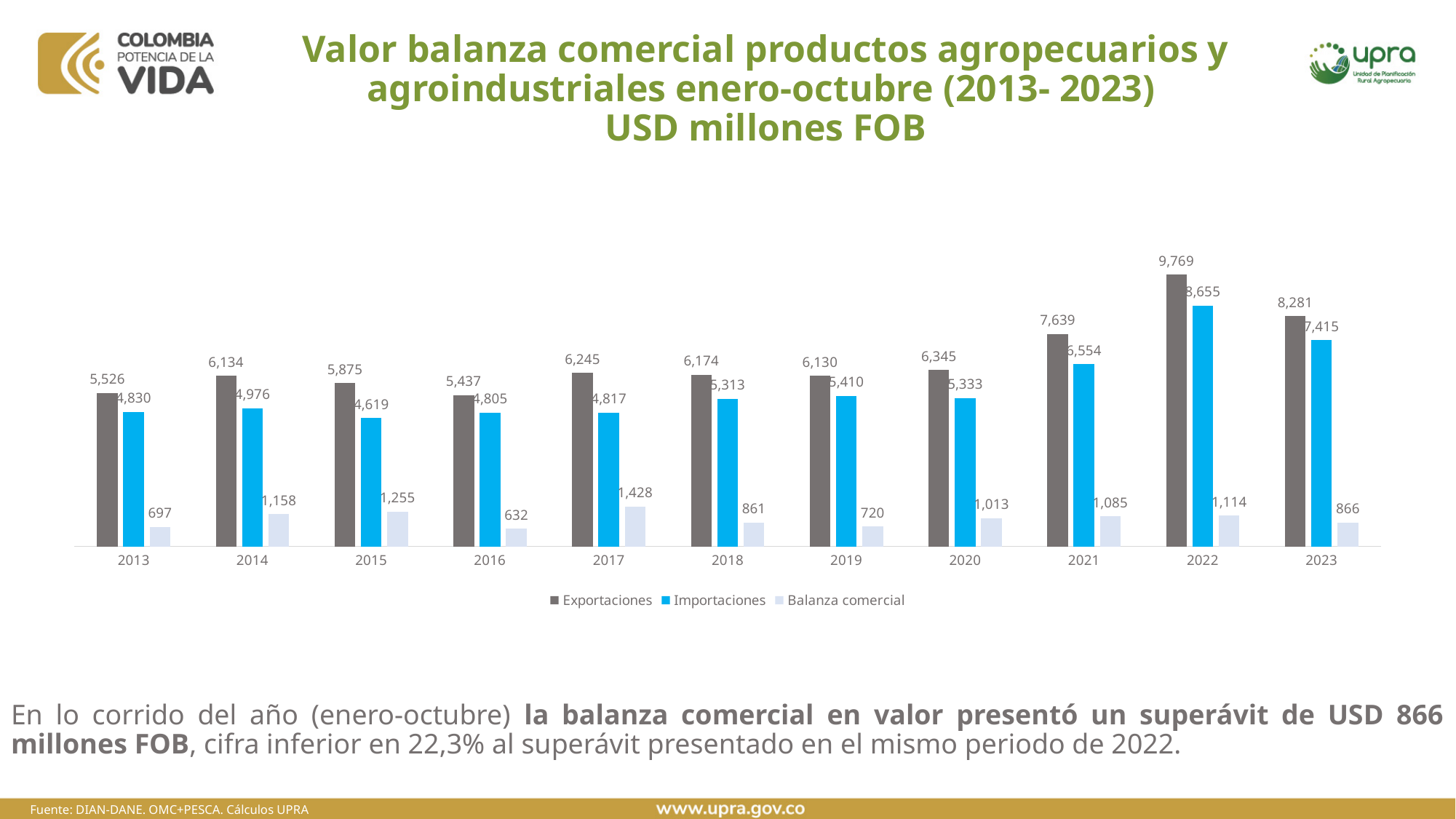
In which year is Balanza comercial lowest? 2016 What is the difference between Balanza comercial in 2017 and in 2016? 796 How many years are shown on the x axis? 11 What is the value of Exportaciones in 2023? 8,281 What is the value of Balanza comercial in 2017? 1,428 What is the value of Importaciones in 2015? 4,619 How many series does the legend list? 3 What kind of chart is shown on the slide? Bar chart In which year is Importaciones lowest? 2015 What is the difference between Exportaciones in 2022 and in 2021? 2,130 In which year is Exportaciones highest? 2022 Which is larger, Importaciones in 2019 or in 2020? 2019